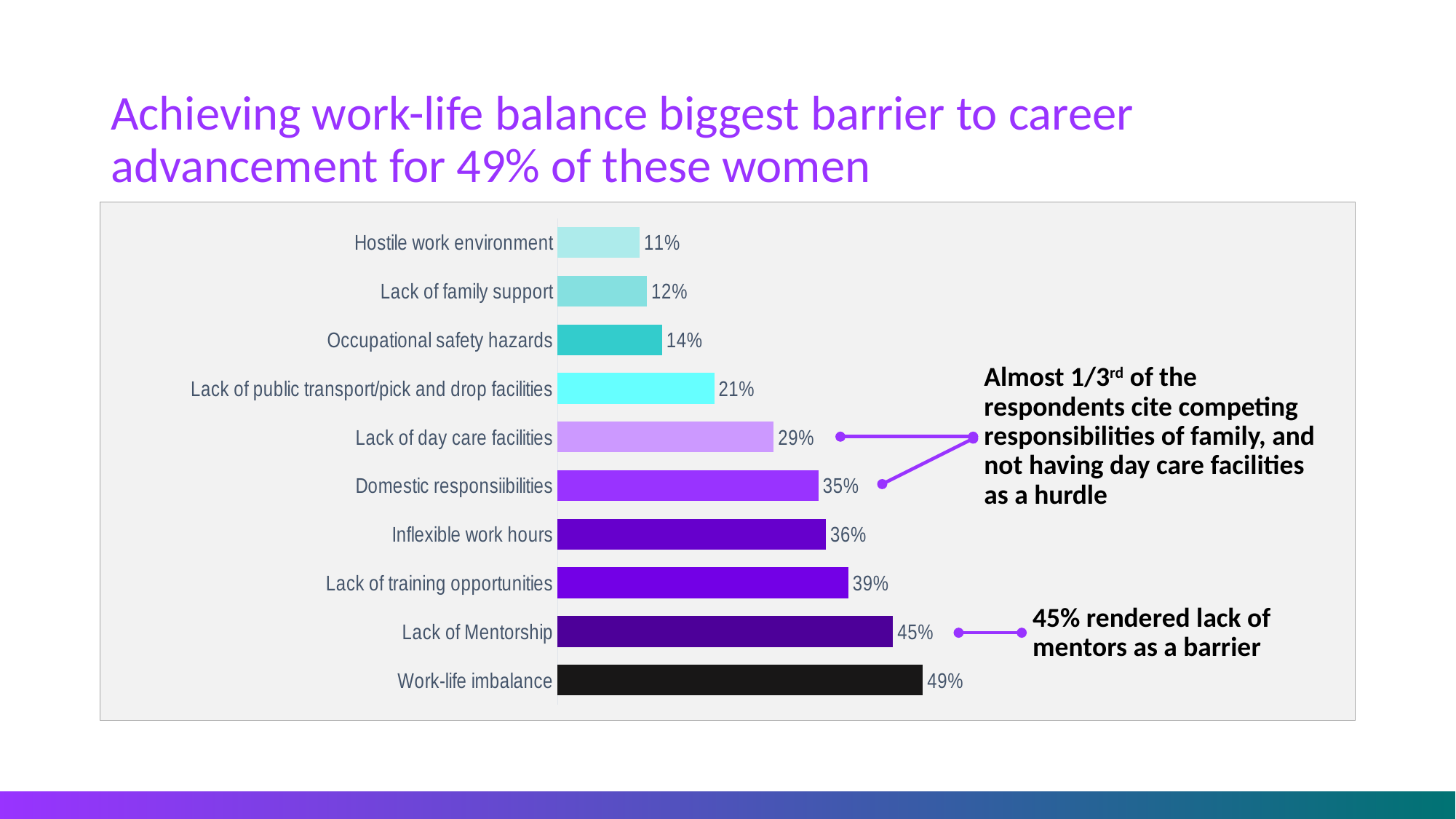
How many categories are shown in the chart? 10 Which is larger, the value for Domestic responsiibilities or the value for Lack of day care facilities? Domestic responsiibilities What colour is the bar for Work-life imbalance? Black What is the difference between the values for Work-life imbalance and Lack of Mentorship? 4% What is the value for Lack of day care facilities? 29% Which category has the highest value? Work-life imbalance Which category has the lowest value? Hostile work environment What is the value for Occupational safety hazards? 14% What is the difference between the values for Lack of training opportunities and Lack of public transport/pick and drop facilities? 18% What is the value for Work-life imbalance? 49% What kind of chart is shown on the slide? Bar chart What is the value for Lack of Mentorship? 45%